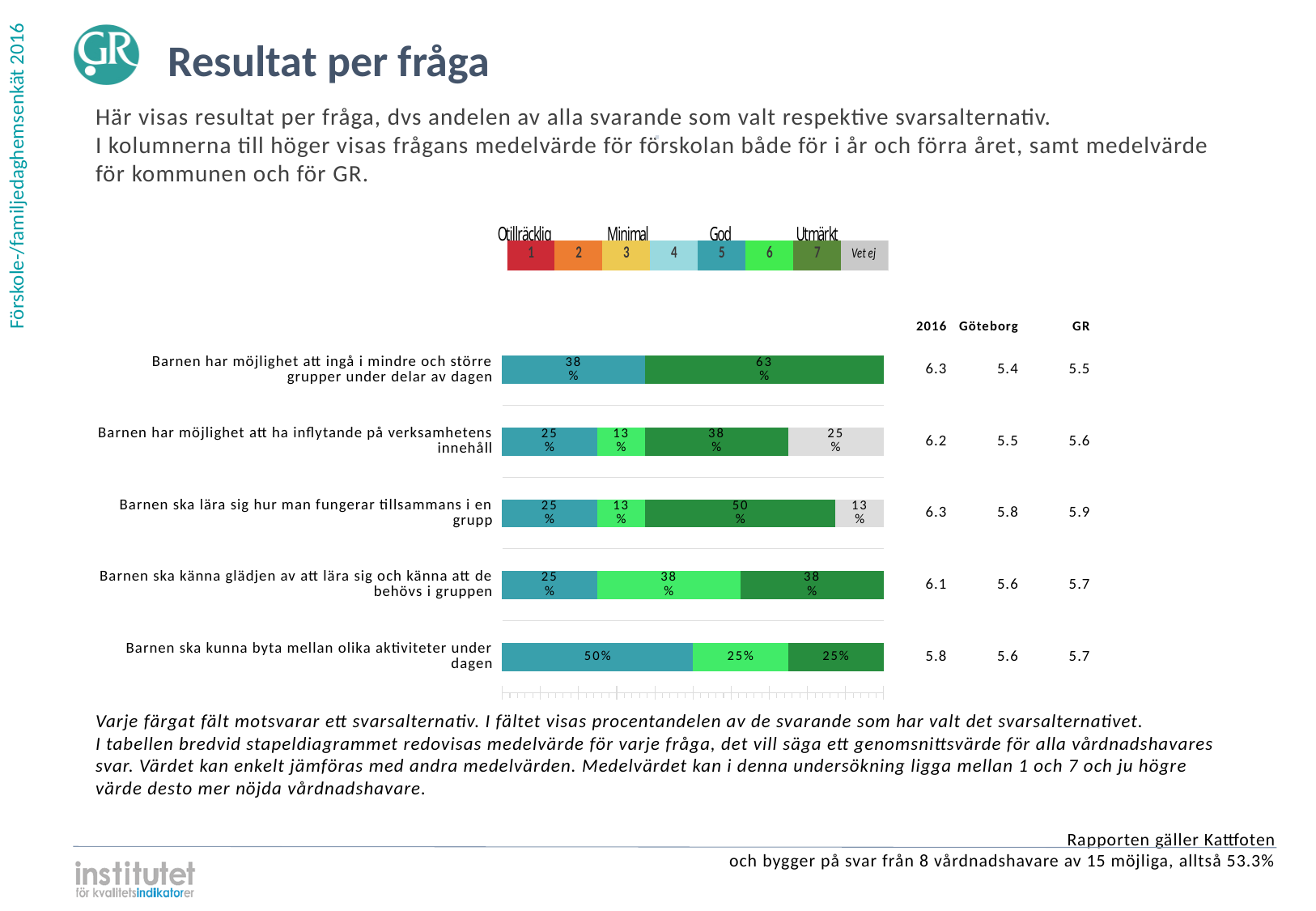
How many questions (categories) are shown as bars in the chart? 5 For 'Barnen ska lära sig hur man fungerar tillsammans i en grupp', which is larger: the share choosing answer 7 or the share choosing answer 5? answer 7 What is the GR mean value for 'Barnen ska lära sig hur man fungerar tillsammans i en grupp'? 5.9 What is the 2016 mean value for 'Barnen ska känna glädjen av att lära sig och känna att de behövs i gruppen'? 6.1 Which question has the lowest 2016 mean value? Barnen ska kunna byta mellan olika aktiviteter under dagen What is the difference between the 2016 mean and the Göteborg mean for 'Barnen har möjlighet att ingå i mindre och större grupper under delar av dagen'? 0.9 What percentage chose 'Vet ej' for 'Barnen har möjlighet att ha inflytande på verksamhetens innehåll'? 25% What is the total of the percentages shown in the bar for 'Barnen ska kunna byta mellan olika aktiviteter under dagen'? 100% What percentage of respondents chose answer 7 (dark green) for 'Barnen har möjlighet att ingå i mindre och större grupper under delar av dagen'? 63% How many entries does the legend above the chart list (including 'Vet ej')? 8 What kind of chart is used to show the results per question? stacked bar chart What percentage chose answer 5 (teal) for 'Barnen ska kunna byta mellan olika aktiviteter under dagen'? 50%